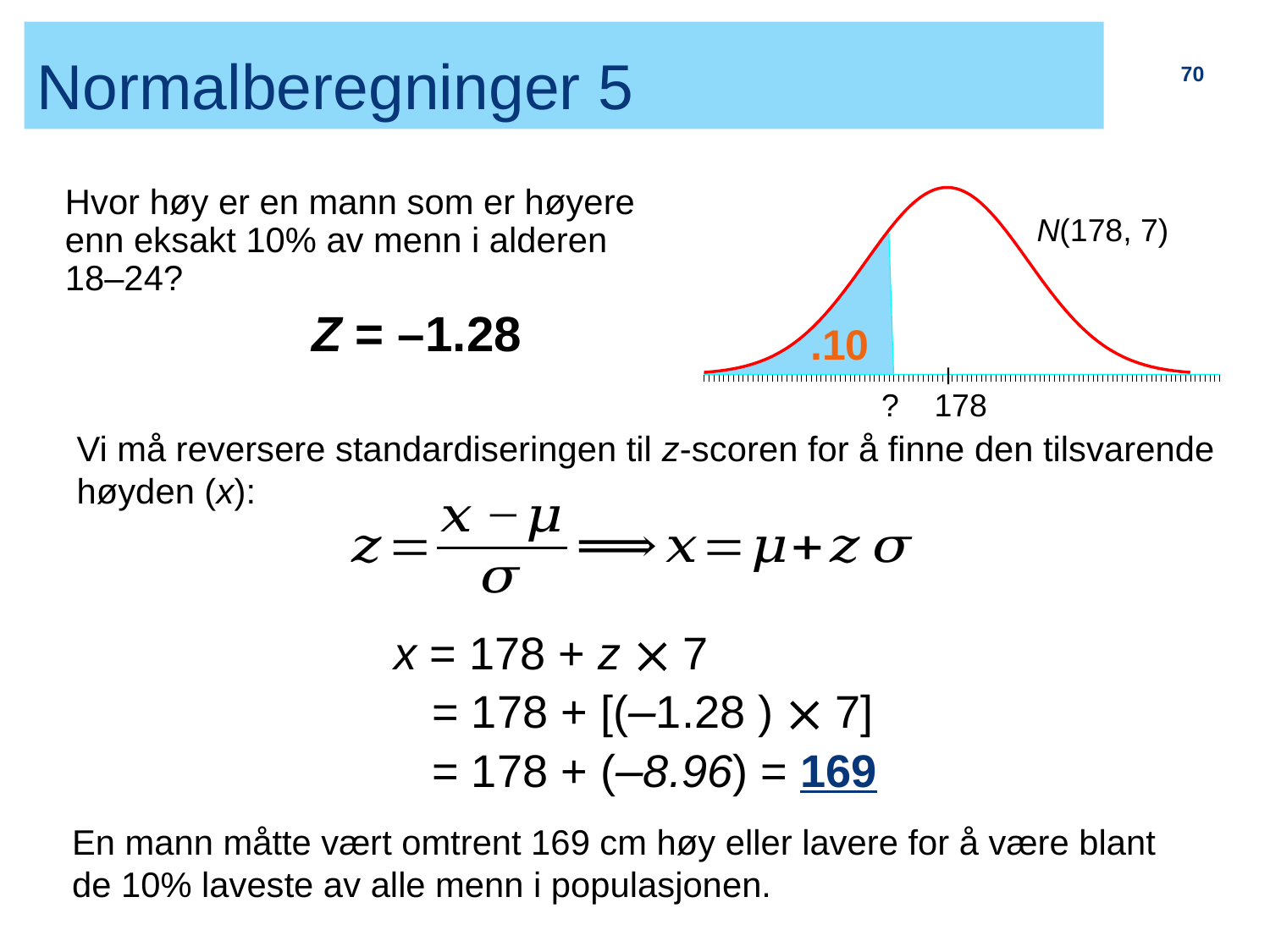
What colour is the shaded area under the left tail of the normal curve? Light blue What proportion is printed inside the shaded region of the normal curve? .10 What symbol marks the unknown position on the horizontal axis of the normal curve? ? What distribution label is printed next to the normal curve? N(178, 7) Is the shaded region of the normal curve located to the left or to the right of 178? Left What value is labelled on the horizontal axis at the centre of the normal curve? 178